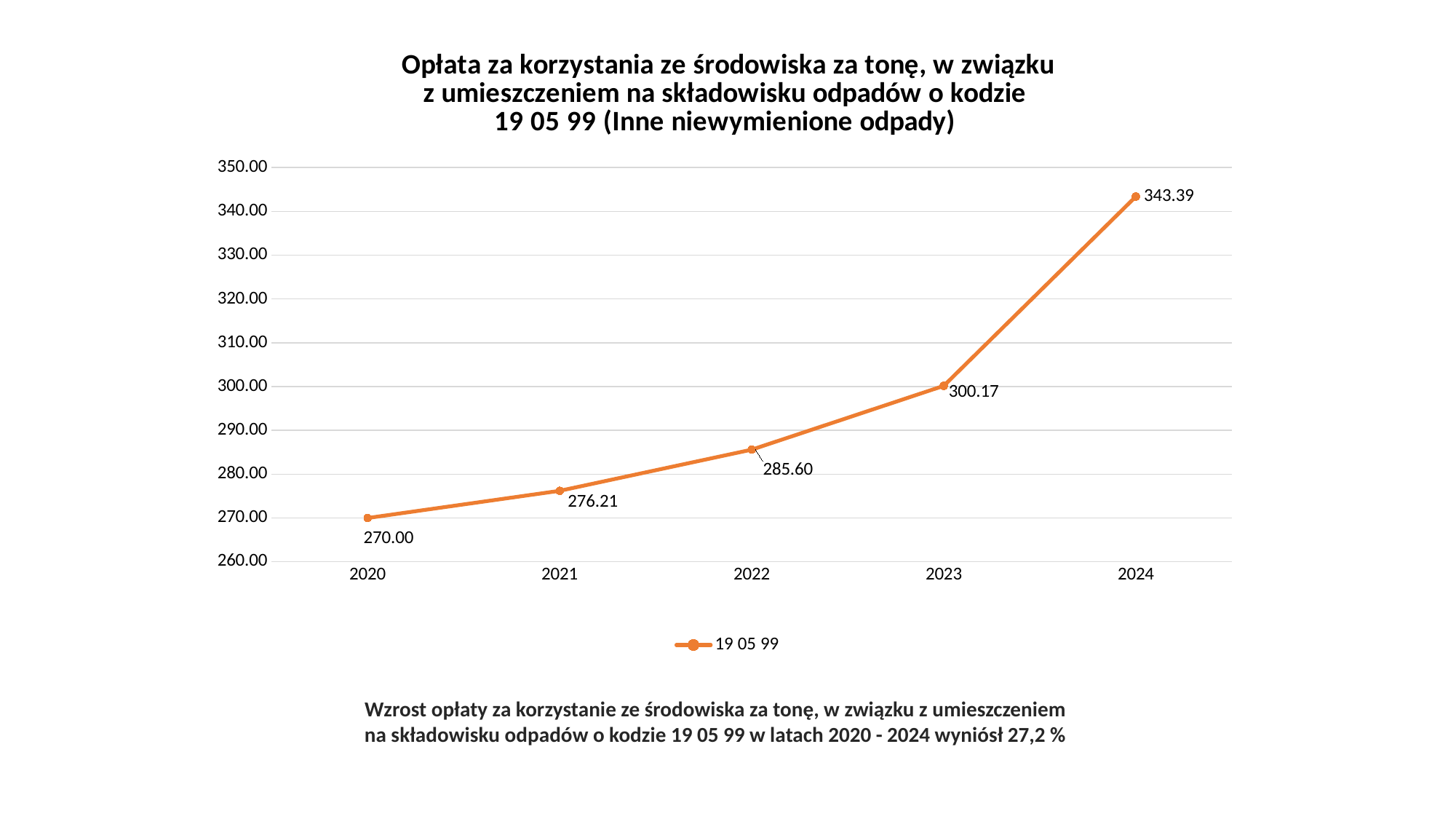
What is the difference between the values for 2021 and 2020? 6.21 How many years are plotted on the x axis? 5 What is the value for 2020? 270.00 Is the value for 2023 greater or less than 290.00? greater What is the difference between the values for 2024 and 2023? 43.22 What is the value for 2024? 343.39 What kind of chart is shown? line chart Do the values rise or fall from 2020 to 2024? rise Which is larger, the value for 2023 or the value for 2022? 2023 Which year has the highest value? 2024 Which year has the lowest value? 2020 What is the value for 2022? 285.60